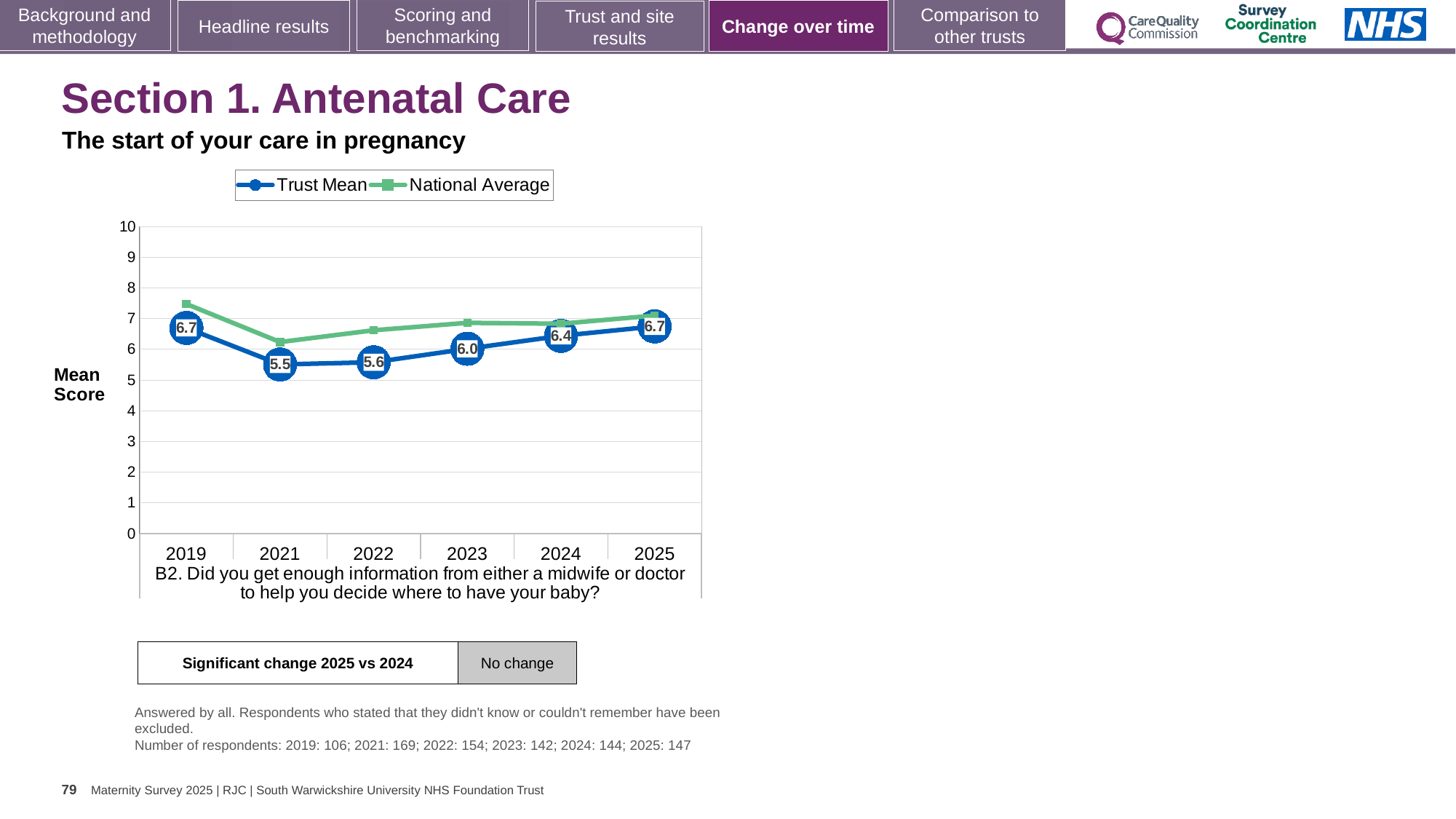
Which is larger, the Trust Mean score for 2024 or for 2022? 2024 How many series does the legend list? 2 What is the difference between the Trust Mean score in 2025 and in 2021? 1.2 What is the Trust Mean score for 2024? 6.4 What does the box labelled 'Significant change 2025 vs 2024' say? No change How many years are plotted on the x axis? 6 What is the Trust Mean score for 2025? 6.7 Does the Trust Mean score rise or fall from 2021 to 2025? rise What kind of chart is shown on the slide? line chart What is the Trust Mean score for 2021? 5.5 In which year is the Trust Mean score lowest? 2021 Is the National Average value for 2019 greater or less than 7? greater